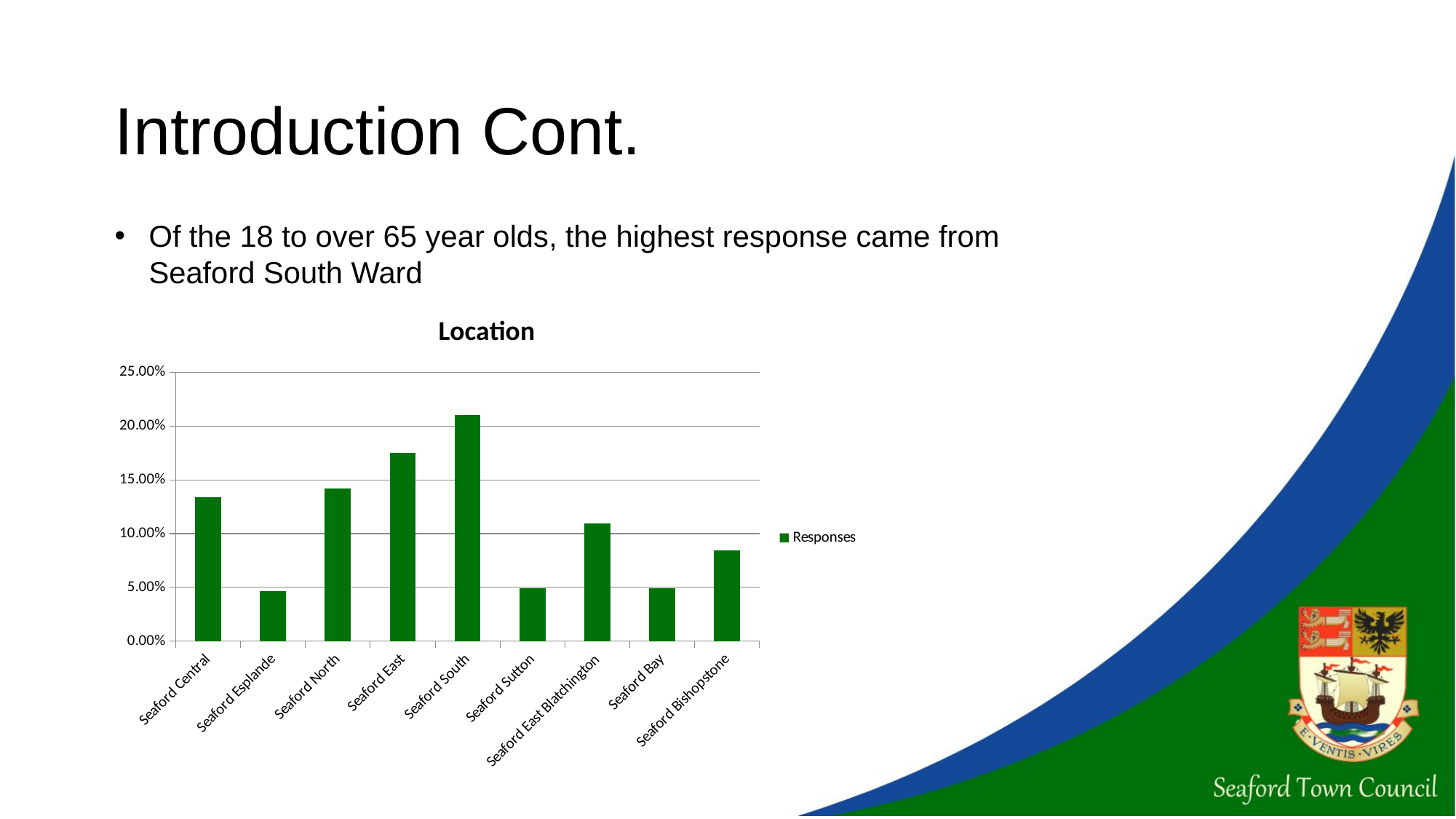
What is the title of the chart? Location Is the value for Seaford South greater or less than 20.00%? greater Is the value for Seaford Bishopstone greater or less than 10.00%? less Which location has the highest response percentage? Seaford South Is the value for Seaford Central greater or less than 10.00%? greater How many categories are shown on the x axis of the chart? 9 Which has a larger value, Seaford East or Seaford North? Seaford East How many series does the chart's legend list? 1 Which has a larger value, Seaford Central or Seaford Bishopstone? Seaford Central What is the name of the series shown in the chart's legend? Responses What type of chart is shown on the slide? bar chart